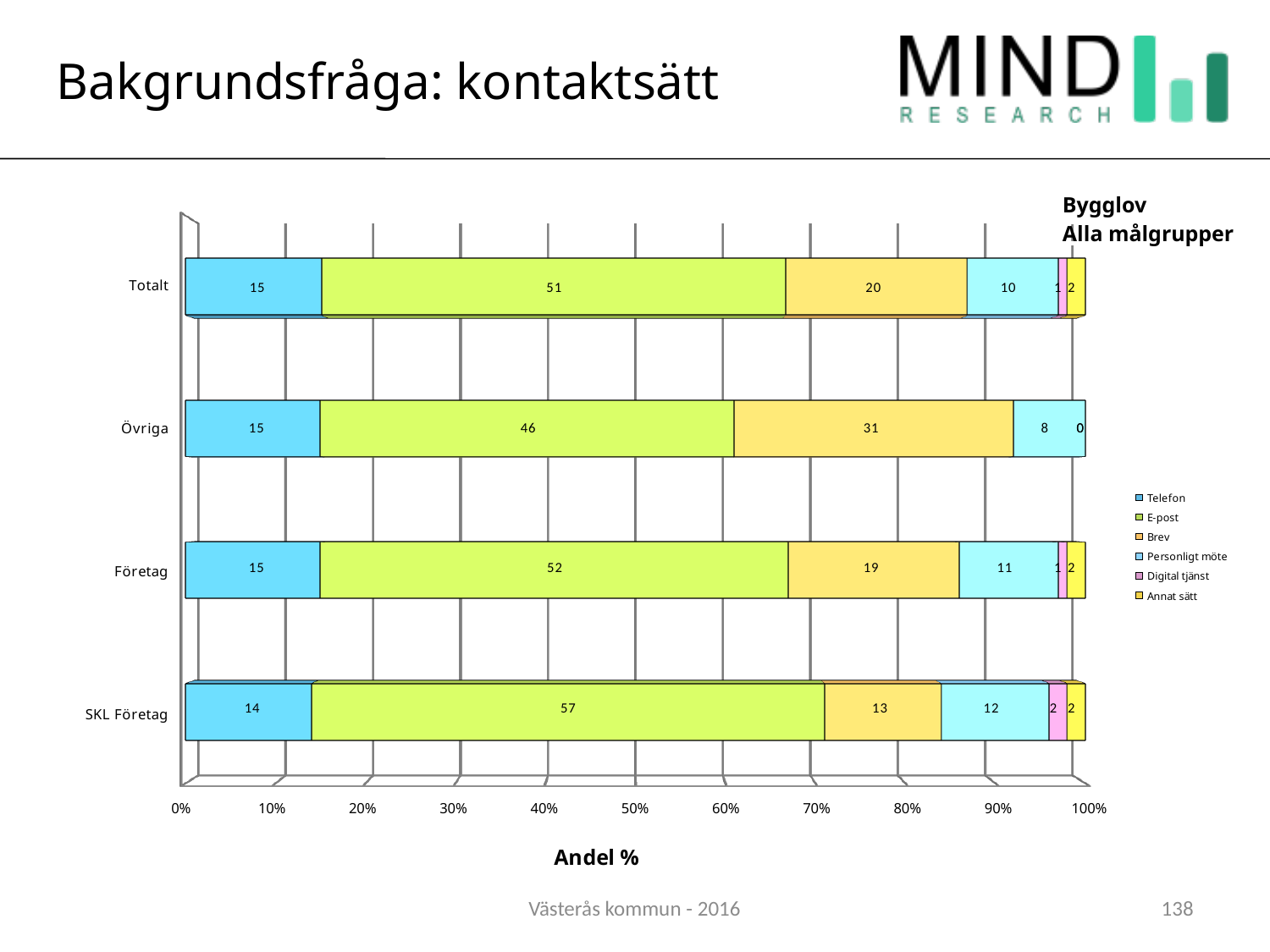
Which category has the highest E-post value? SKL Företag How many series does the legend list? 6 What is the Personligt möte value for SKL Företag? 12 Which is larger, the E-post value for Företag or for Övriga? Företag How many categories are shown on the y axis? 4 What kind of chart is shown on the slide? Stacked bar chart What is the label of the x axis? Andel % Which category has the lowest Brev value? SKL Företag What is the Brev value for Övriga? 31 What is the difference between the Brev values for Övriga and Totalt? 11 What is the Telefon value for Företag? 15 What is the E-post value for Totalt? 51